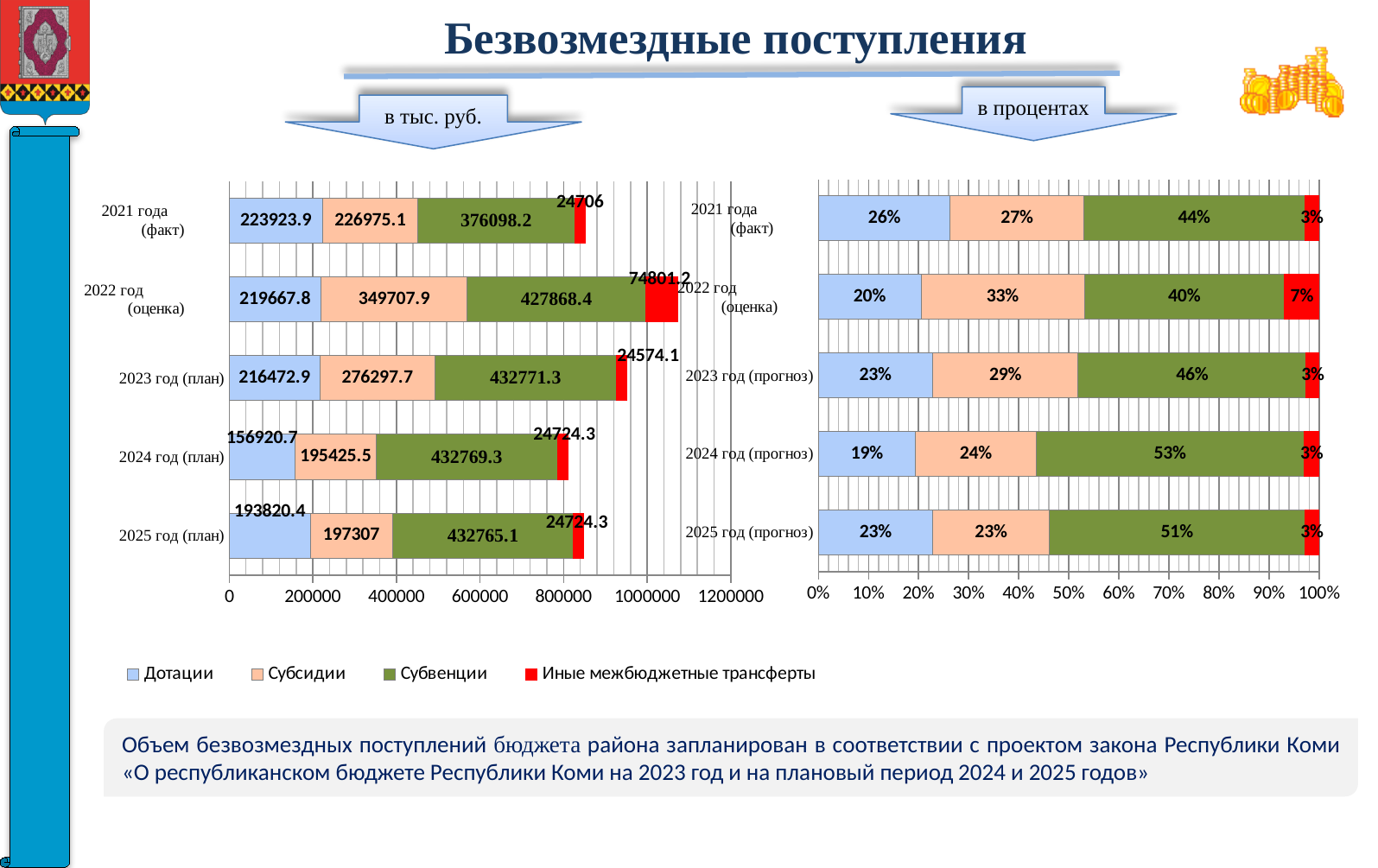
In the chart 'в тыс. руб.', which year has the lowest value for Дотации? 2024 год (план) In the chart 'в тыс. руб.', which year has the highest value for Субсидии? 2022 год (оценка) In the chart 'в процентах', what share do Иные межбюджетные трансферты make up for 2022 год (оценка)? 7% How many series does the legend list? 4 In the chart 'в процентах', which is larger: the Дотации share for 2021 года (факт) or for 2025 год (прогноз)? 2021 года (факт) How many categories (years) are shown in the chart 'в процентах'? 5 In the chart 'в тыс. руб.', what is the value of Дотации for 2024 год (план)? 156920.7 In the chart 'в тыс. руб.', what is the total of the stacked bar for 2023 год (план)? 950116 What type of chart is the chart 'в тыс. руб.'? Stacked bar chart In the chart 'в тыс. руб.', what is the value of Субвенции for 2023 год (план)? 432771.3 In the chart 'в тыс. руб.', what is the difference between the Субвенции values for 2022 год (оценка) and 2021 года (факт)? 51770.2 In the chart 'в процентах', what share do Субвенции make up for 2024 год (прогноз)? 53%